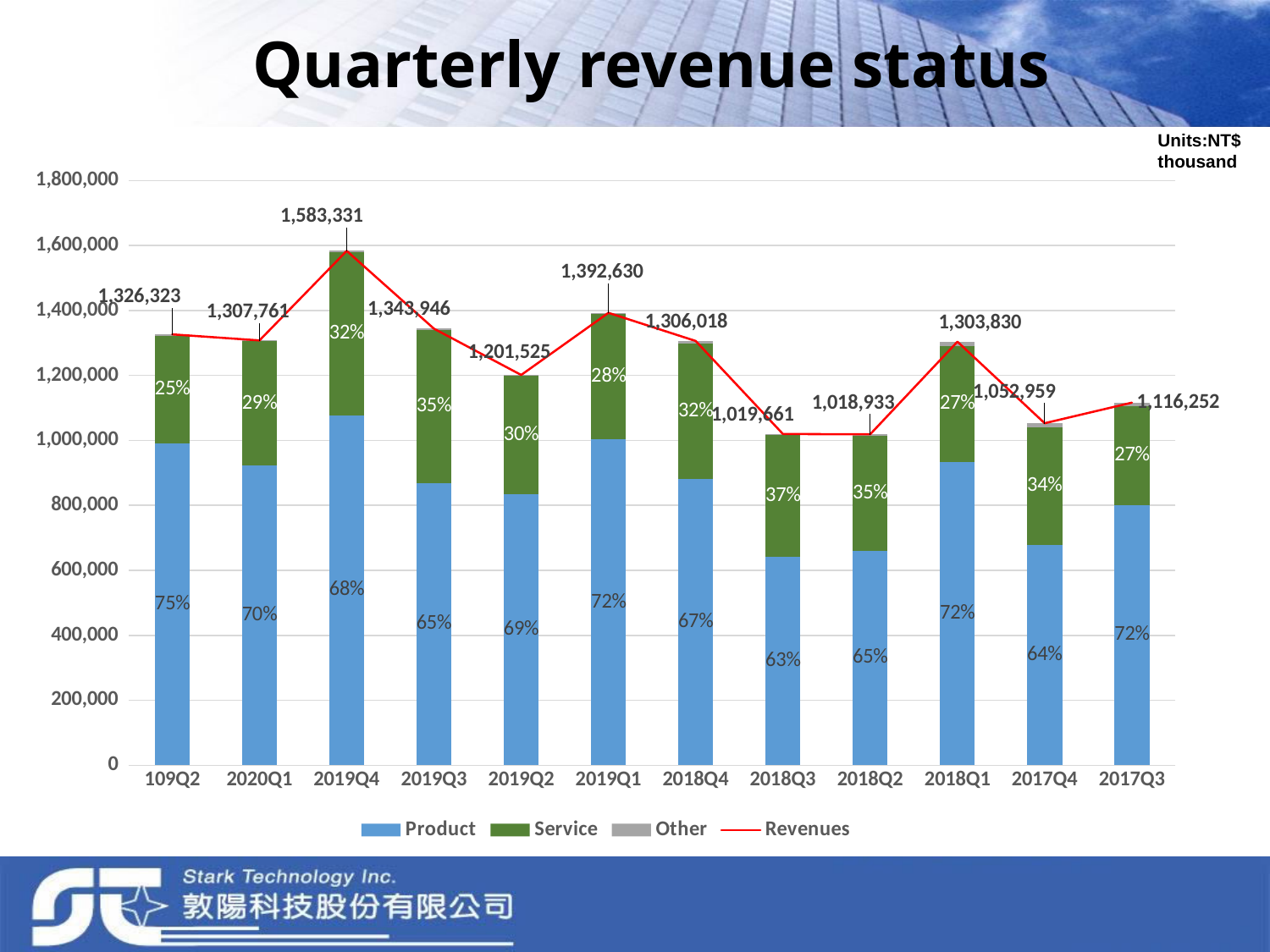
What is the revenue value shown for 2018Q2? 1,018,933 Which quarter has higher revenue, 2019Q3 or 2019Q2? 2019Q3 Which quarter has the highest revenue? 2019Q4 Which quarter has the lowest revenue? 2018Q2 How many quarters are shown on the x axis? 12 What units are the values in, according to the note on the slide? NT$ thousand Is the Product bar for 2018Q3 greater or less than 800,000? less What percentage of revenue does Service account for in 2018Q3? 37% What percentage of revenue does Product account for in 109Q2? 75% What is the difference in revenue between 2019Q4 and 2019Q1? 190,701 What is the revenue value shown for 2019Q4? 1,583,331 How many series does the legend list? 4